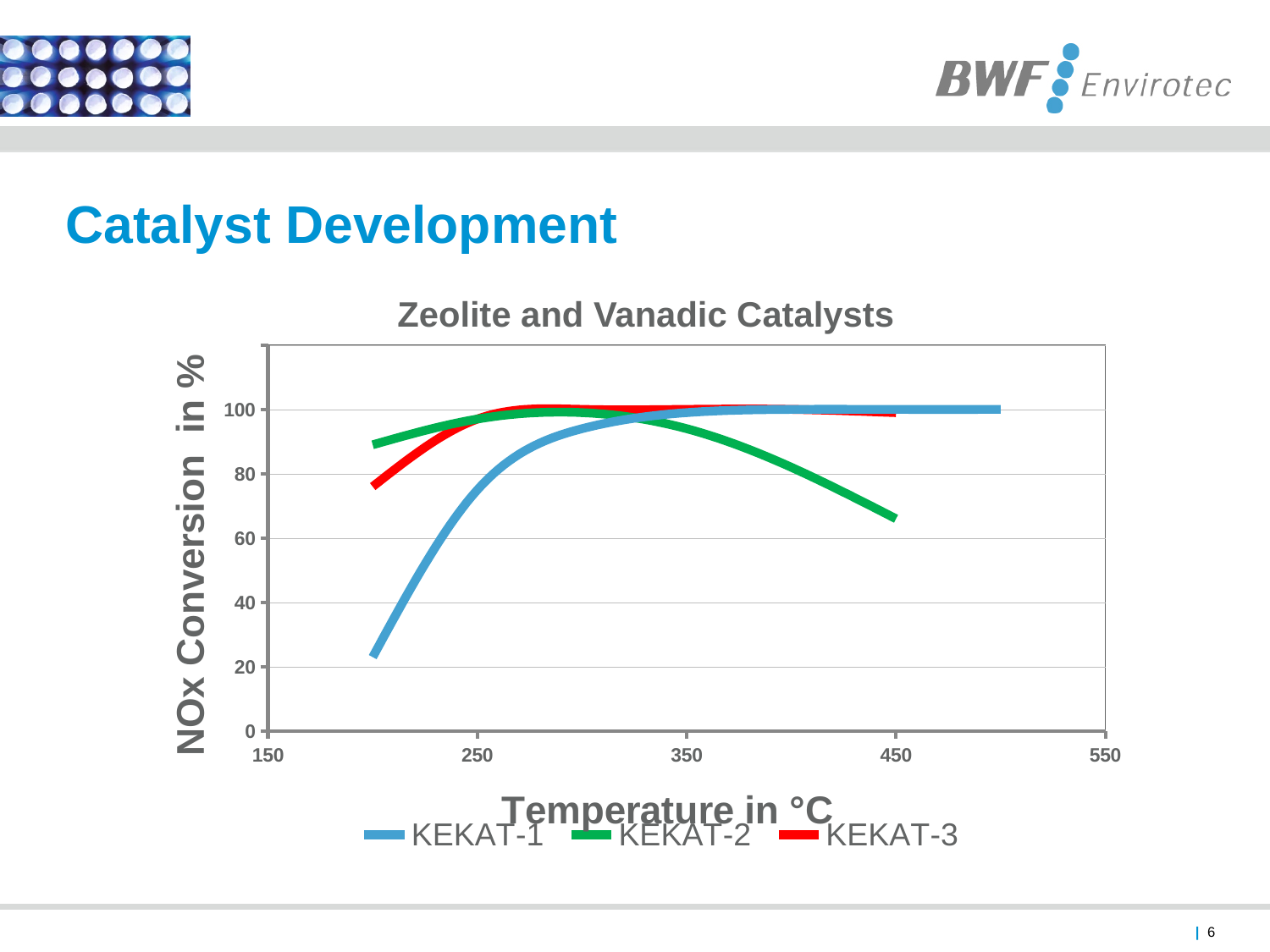
Is the NOx conversion for KEKAT-2 at 200 °C greater or less than 80? greater Is the NOx conversion for KEKAT-1 at 200 °C greater or less than 40? less At 200 °C, which series has the higher NOx conversion, KEKAT-1 or KEKAT-2? KEKAT-2 Is the NOx conversion for KEKAT-2 at 450 °C greater or less than 60? greater At 450 °C, which series has the higher NOx conversion, KEKAT-1 or KEKAT-2? KEKAT-1 Does the NOx conversion for KEKAT-1 rise or fall as temperature increases? rise What is the title of the chart? Zeolite and Vanadic Catalysts Which series has the lowest NOx conversion at 200 °C? KEKAT-1 What is the label of the x axis? Temperature in °C What kind of chart is shown on the slide? line chart How many series does the legend list? 3